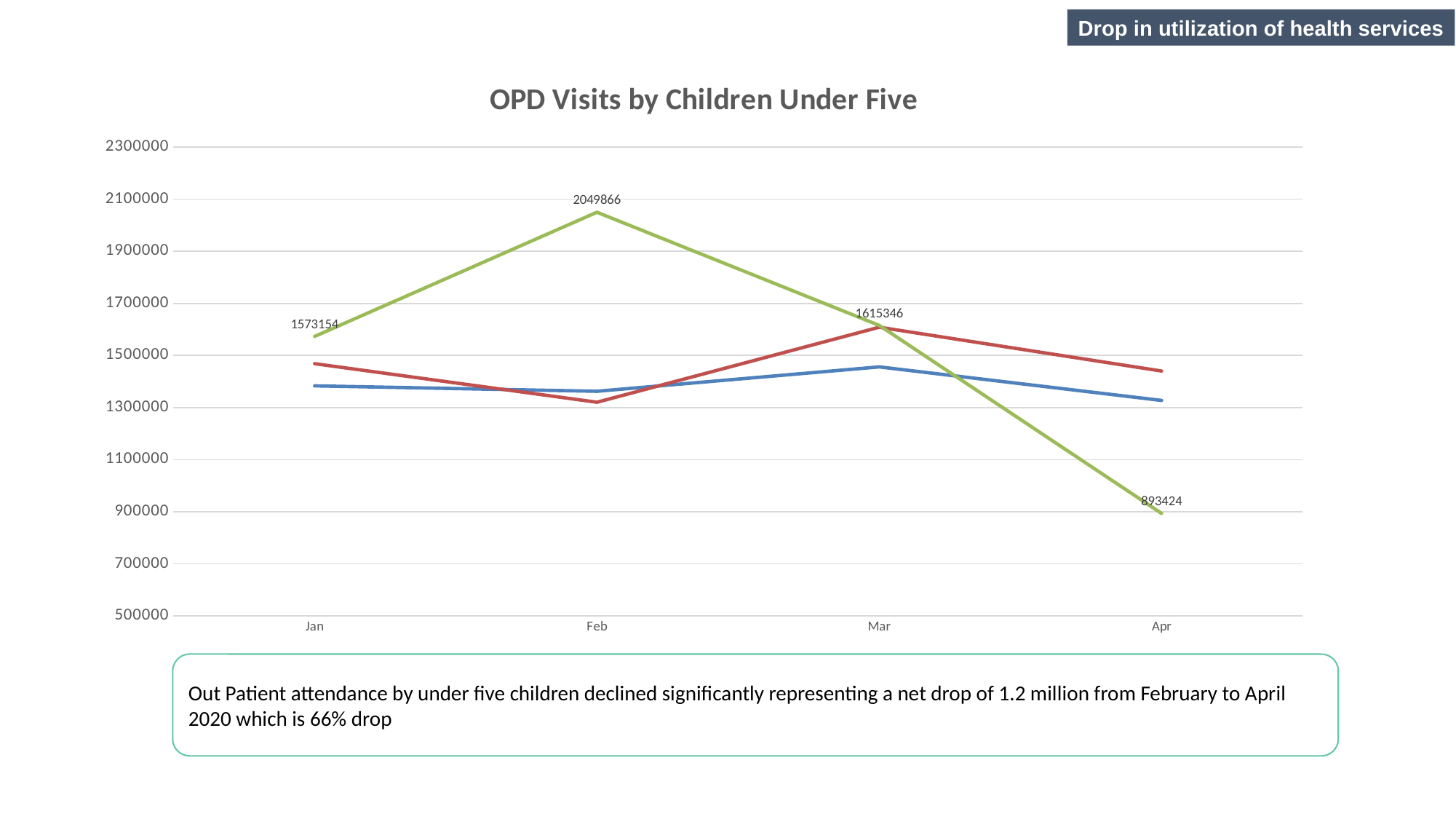
What type of chart is shown on the slide? line chart How many lines are plotted on the chart? 3 What is the value of the green line in Apr? 893424 What is the value of the green line in Feb? 2049866 What is the difference between the green line's Feb value and its Apr value? 1156442 Does the green line rise or fall from Feb to Apr? fall How many months are shown on the x axis? 4 In which month does the green line reach its highest value? Feb What is the value of the green line in Jan? 1573154 In which month does the green line reach its lowest value? Apr Is the value of the red line in Feb greater or less than 1500000? less What is the title of the chart? OPD Visits by Children Under Five